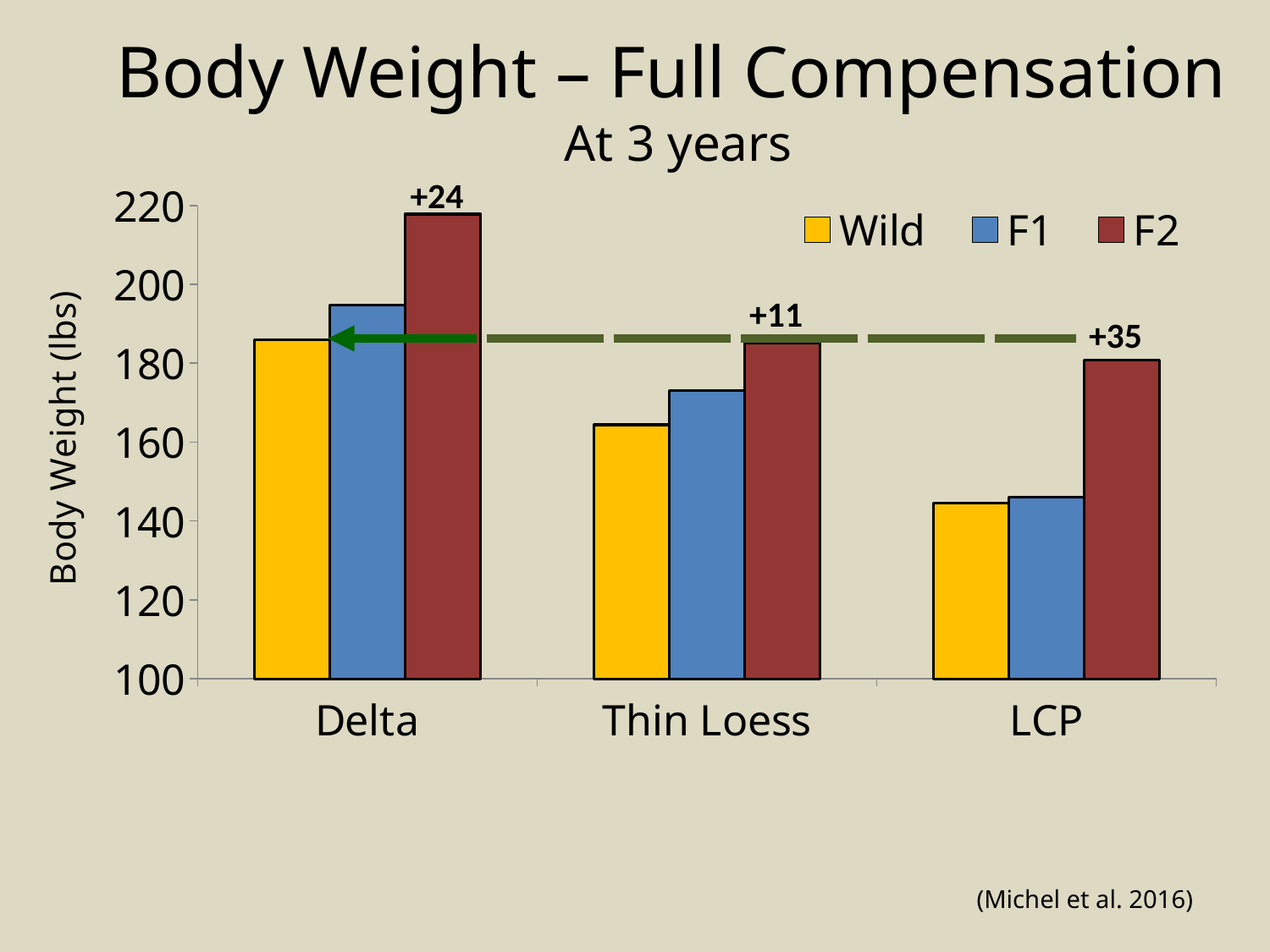
Is the F2 value for Delta greater or less than 200? greater Which series are listed in the legend? Wild, F1, F2 Which is larger, the F1 value for Thin Loess or the F2 value for LCP? F2 value for LCP Do the Wild values rise or fall moving from Delta to LCP along the x axis? fall What is the y-axis label of the chart? Body Weight (lbs) Is the F2 value for LCP greater or less than 160? greater What kind of chart is shown on the slide? bar chart Which category has the lowest Wild value? LCP How many series does the legend list? 3 Is the Wild value for LCP greater or less than 160? less How many categories are shown on the x axis? 3 Which category has the tallest F2 bar? Delta